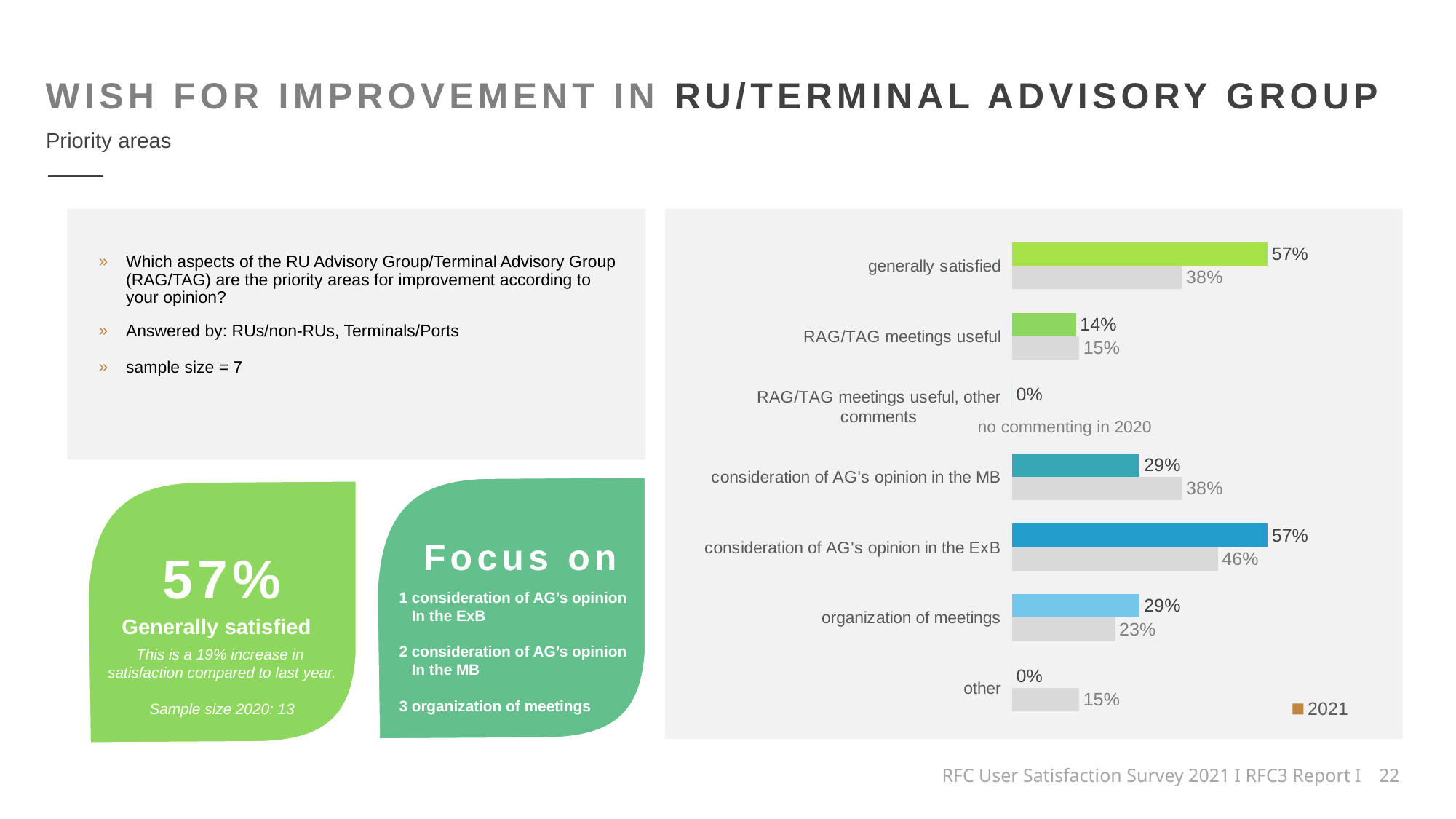
What kind of chart is shown on the slide? bar chart What is the difference between the 2021 values for 'consideration of AG's opinion in the ExB' and 'consideration of AG's opinion in the MB'? 28% Which category has the highest grey (2020) value? consideration of AG's opinion in the ExB What is the 2021 value for 'organization of meetings'? 29% What is the 2021 value for 'RAG/TAG meetings useful'? 14% How many categories are shown on the chart? 7 Which is larger for 'consideration of AG's opinion in the MB': the 2021 value or the 2020 value? 2020 value (38%) How many series does the chart legend list? 1 What is the difference between the 2021 and 2020 values for 'generally satisfied'? 19% What is the 2021 value for 'generally satisfied'? 57% What is the grey (2020) value for 'consideration of AG's opinion in the ExB'? 46% What is the 2021 value for 'other'? 0%